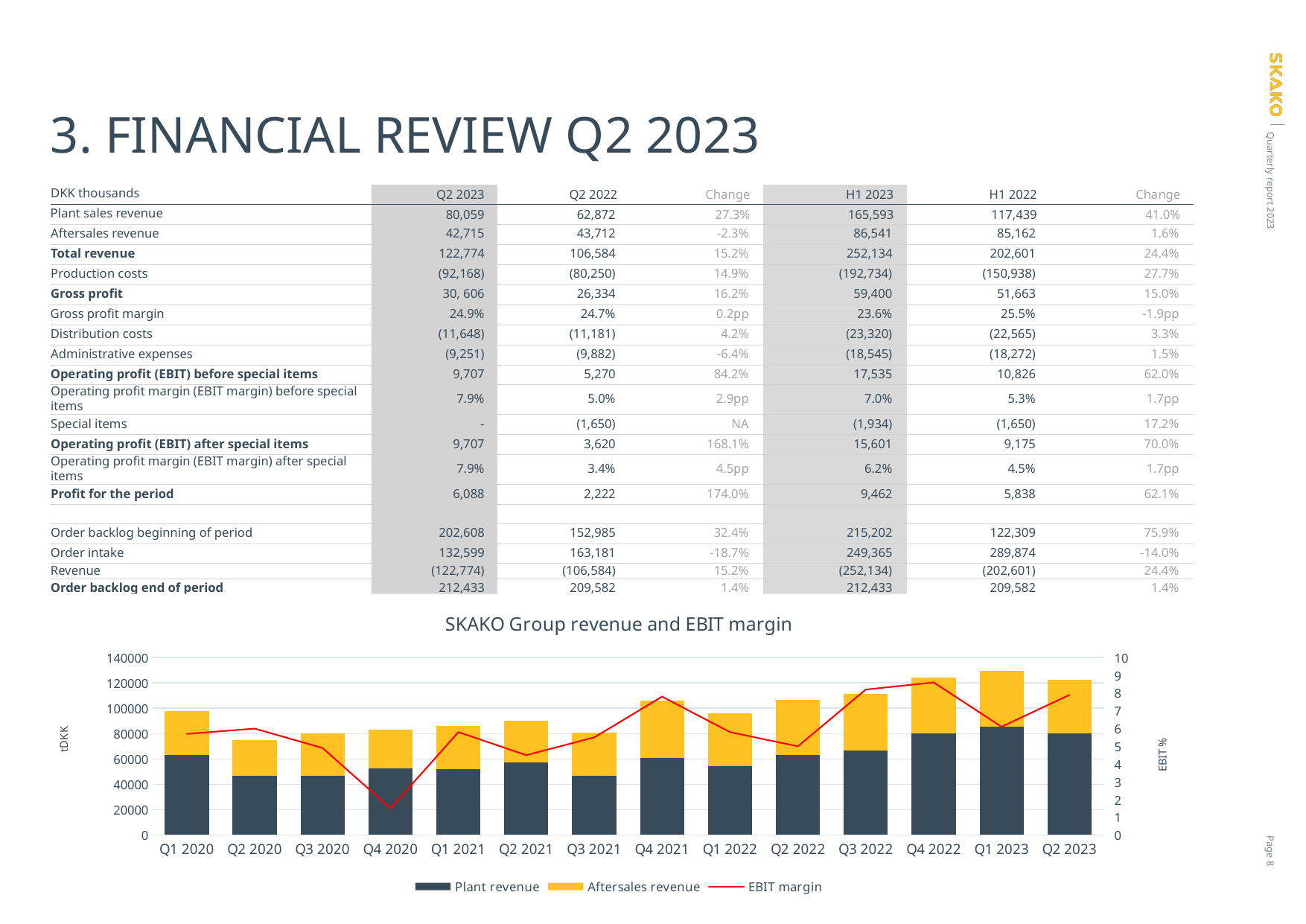
In the 'SKAKO Group revenue and EBIT margin' chart, is the total revenue bar for Q1 2023 greater or less than 120000? greater In the 'SKAKO Group revenue and EBIT margin' chart, what colour represents Aftersales revenue? Yellow How many series does the legend of the 'SKAKO Group revenue and EBIT margin' chart list? 3 In the 'SKAKO Group revenue and EBIT margin' chart, does total revenue rise or fall from Q1 2022 to Q1 2023? rise In the 'SKAKO Group revenue and EBIT margin' chart, which quarter has the larger total revenue bar, Q4 2021 or Q1 2022? Q4 2021 In the 'SKAKO Group revenue and EBIT margin' chart, is the EBIT margin for Q4 2020 greater or less than 3? less In the 'SKAKO Group revenue and EBIT margin' chart, which quarter has the shortest total revenue bar? Q2 2020 What kind of chart is 'SKAKO Group revenue and EBIT margin'? A stacked bar chart with a line for EBIT margin In the 'SKAKO Group revenue and EBIT margin' chart, which quarter has the tallest total revenue bar? Q1 2023 In the 'SKAKO Group revenue and EBIT margin' chart, in which quarter is the EBIT margin line at its highest? Q4 2022 How many quarters are shown on the x axis of the 'SKAKO Group revenue and EBIT margin' chart? 14 In the 'SKAKO Group revenue and EBIT margin' chart, in which quarter is the EBIT margin line at its lowest? Q4 2020